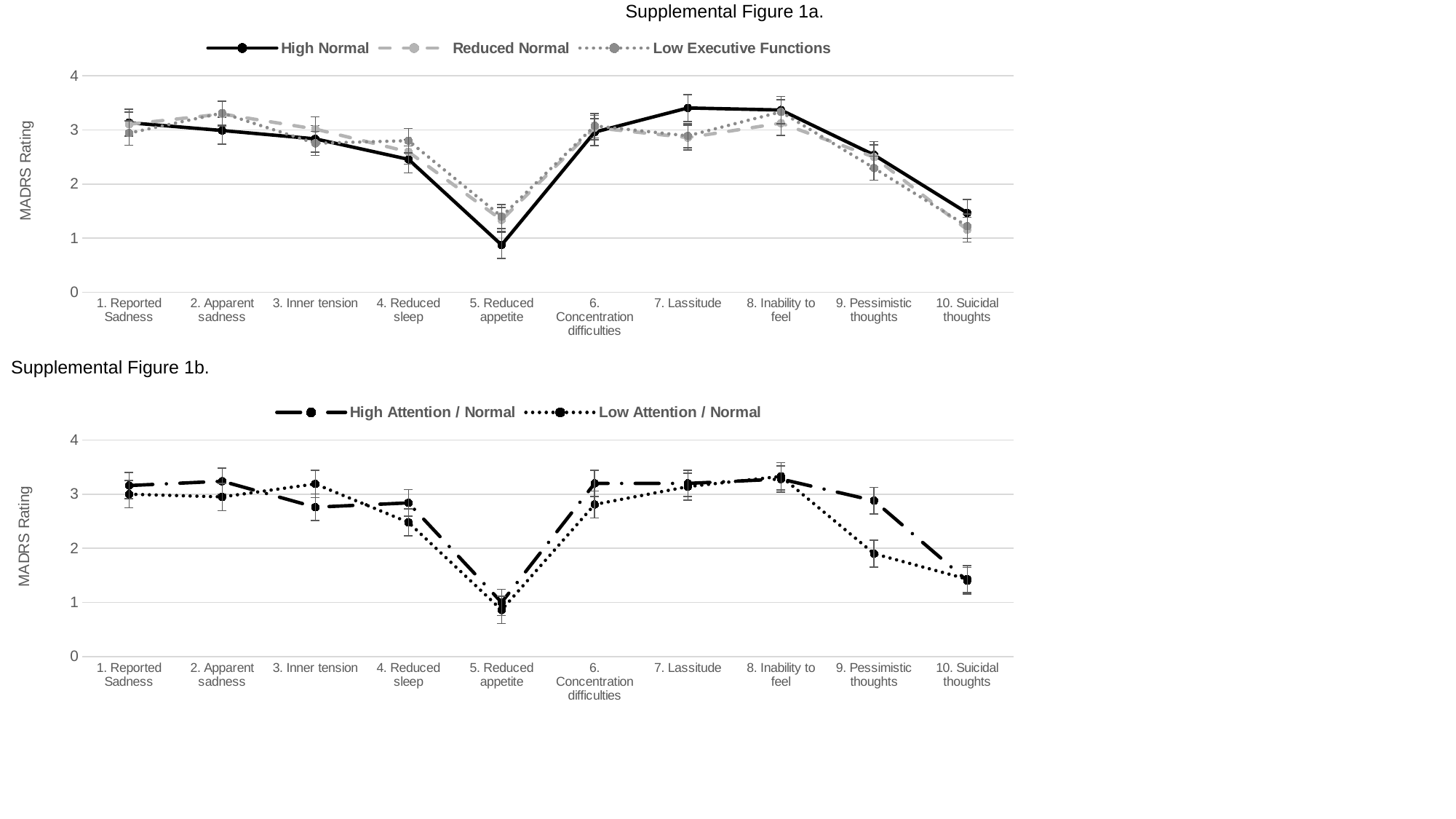
In Supplemental Figure 1a, is the value for Low Executive Functions at 9. Pessimistic thoughts greater or less than 3? less How many series does the legend of Supplemental Figure 1b list? 2 In Supplemental Figure 1b, do the values of the High Attention / Normal series rise or fall from 8. Inability to feel to 10. Suicidal thoughts? Fall In Supplemental Figure 1b, at which category does the Low Attention / Normal series reach its lowest value? 5. Reduced appetite In Supplemental Figure 1a, at which category does the High Normal series reach its lowest value? 5. Reduced appetite In Supplemental Figure 1a, is the value for Reduced Normal at 10. Suicidal thoughts greater or less than 2? less How many categories are shown on the x axis of Supplemental Figure 1b? 10 In Supplemental Figure 1b, which series has the larger value at 9. Pessimistic thoughts, High Attention / Normal or Low Attention / Normal? High Attention / Normal What kind of chart is Supplemental Figure 1a? Line chart In Supplemental Figure 1a, is the value for High Normal at 7. Lassitude greater or less than 3? greater How many series does the legend of Supplemental Figure 1a list? 3 What is the y-axis label of Supplemental Figure 1b? MADRS Rating